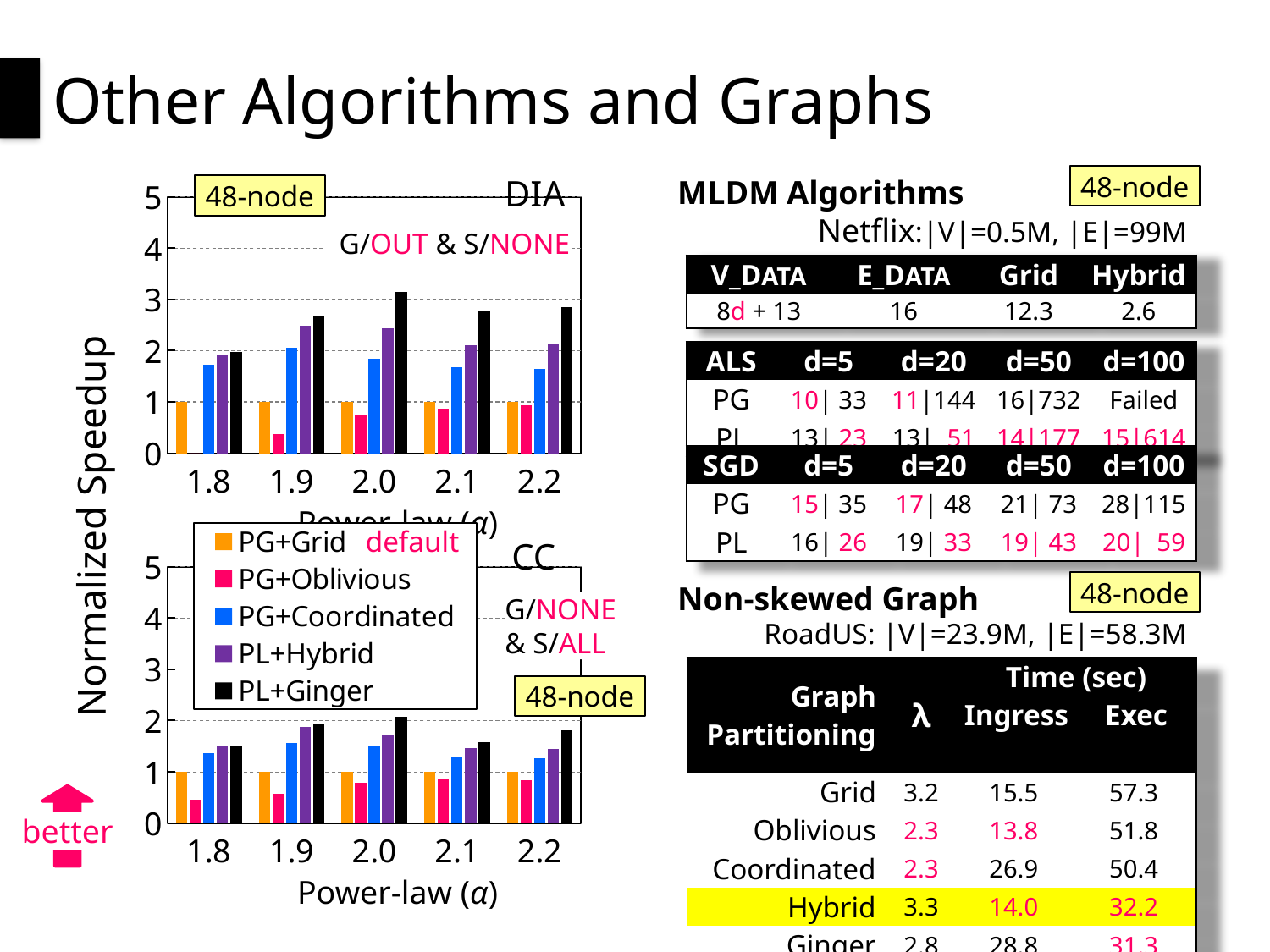
In the DIA chart, is the value for PL+Ginger at α = 2.0 greater or less than 2? greater In the DIA chart, at α = 2.0, which is larger: PL+Hybrid or PG+Coordinated? PL+Hybrid In the DIA chart, at which Power-law (α) value is the PL+Ginger bar highest? 2.0 In the DIA chart, which series has the lowest bar at α = 1.9? PG+Oblivious How many Power-law (α) categories are shown on the x axis of the CC chart? 5 In the CC chart, at α = 2.2, which is larger: PL+Ginger or PL+Hybrid? PL+Ginger What kind of chart is the DIA chart at the top left of the slide? bar chart What is the label on the shared y axis of the DIA and CC charts? Normalized Speedup How many series does the legend shared by the DIA and CC charts list? 5 In the DIA chart, is the value for PG+Oblivious at α = 1.9 greater or less than 1? less In the DIA chart, what is the value of PG+Grid at α = 1.8? 1 In the CC chart, which series has the highest bar at α = 2.0? PL+Ginger